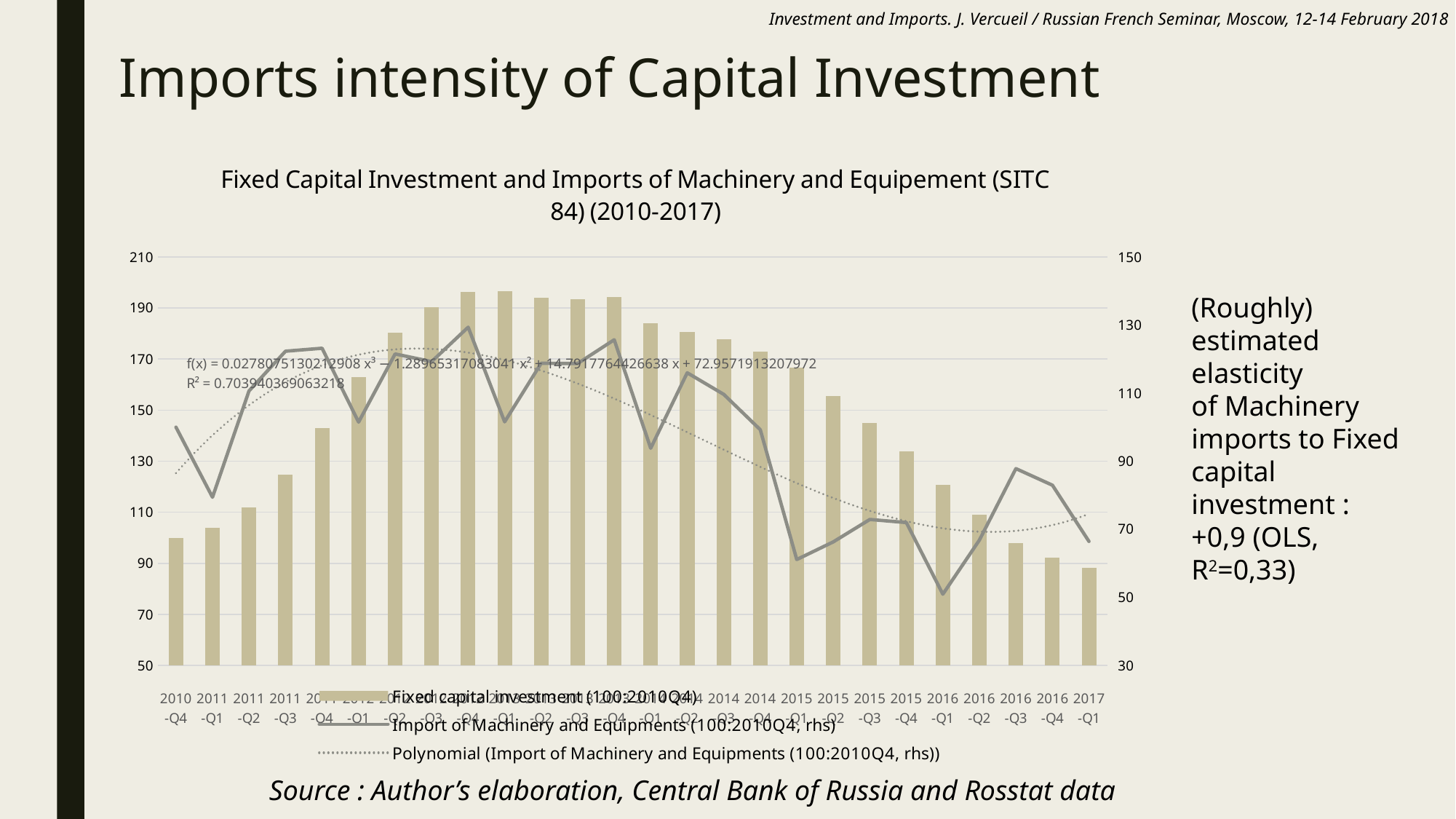
Which is larger, the Fixed capital investment bar for 2014-Q1 or for 2015-Q2? 2014-Q1 Is the Fixed capital investment bar for 2013-Q4 greater or less than 190? greater How many quarterly categories are plotted along the x axis? 26 In which quarter does the Import of Machinery and Equipments line reach its lowest point? 2016-Q1 Do the Fixed capital investment bars rise or fall from 2013-Q1 to 2017-Q1? fall What is the title of the chart? Fixed Capital Investment and Imports of Machinery and Equipement (SITC 84) (2010-2017) Is the Fixed capital investment bar for 2010-Q4 greater or less than 110? less Which series is drawn as bars? Fixed capital investment (100:2010Q4) How many series does the chart legend list? 3 Is the Fixed capital investment bar for 2016-Q1 greater or less than 130? less What kind of chart is shown on the slide? A combined bar and line chart